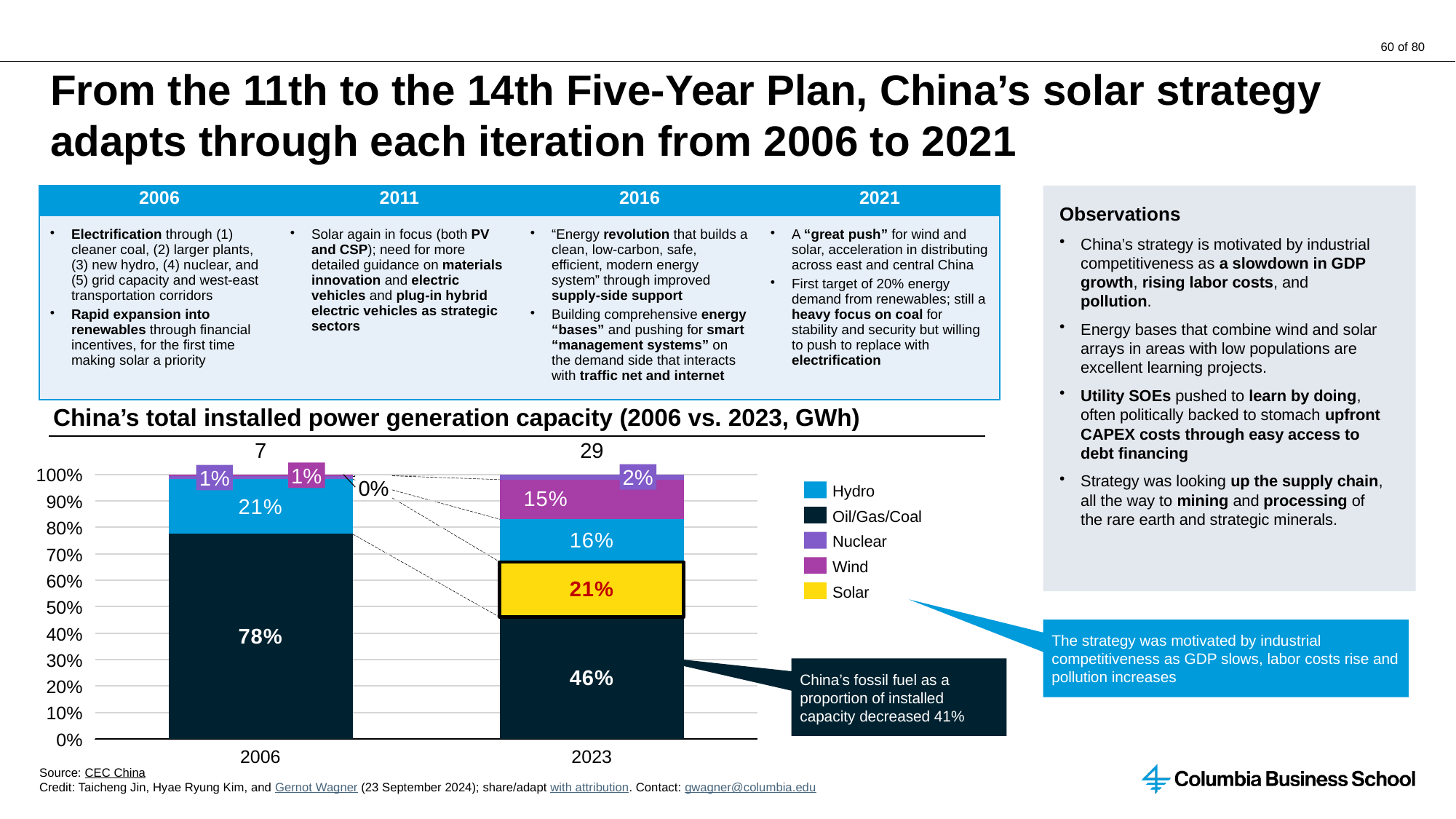
How many series does the legend of the installed capacity chart list? 5 What share of China's installed capacity was Hydro in 2006? 21% Which source had the largest share of installed capacity in 2023? Oil/Gas/Coal What kind of chart is shown under the title "China's total installed power generation capacity (2006 vs. 2023, GWh)"? Stacked bar chart What share of China's installed capacity was Oil/Gas/Coal in 2006? 78% How many years (categories) are plotted on the x axis of the installed capacity chart? 2 Which is larger in 2023: the Hydro share or the Wind share? Hydro What share of China's installed capacity was Solar in 2023? 21% What total value is printed above the 2023 bar in the installed capacity chart? 29 What share of China's installed capacity was Wind in 2023? 15% What share of China's installed capacity was Oil/Gas/Coal in 2023? 46% By how many percentage points did the Oil/Gas/Coal share fall from 2006 to 2023? 32